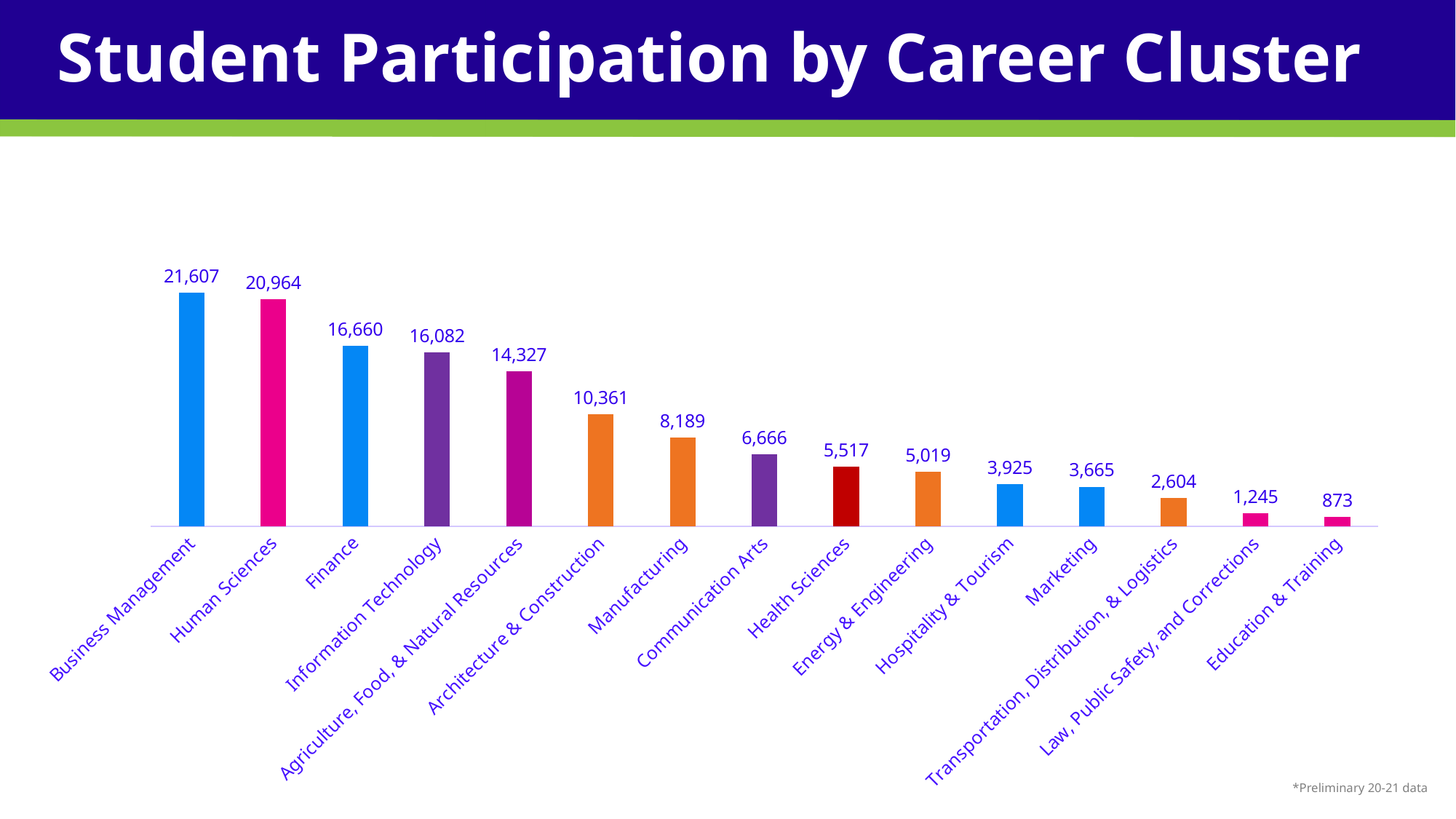
What kind of chart is shown on the slide? Bar chart Which career cluster has the lowest student participation? Education & Training How many career clusters are shown in the chart? 15 Which career cluster has the highest student participation? Business Management What is the difference between Manufacturing and Communication Arts? 1,523 Which is larger, Information Technology or Agriculture, Food, & Natural Resources? Information Technology What is the value for Finance? 16,660 Which is larger, Marketing or Hospitality & Tourism? Hospitality & Tourism What is the difference between Business Management and Human Sciences? 643 What is the value for Law, Public Safety, and Corrections? 1,245 What is the value for Health Sciences? 5,517 Do the values rise or fall from left to right along the x axis? Fall